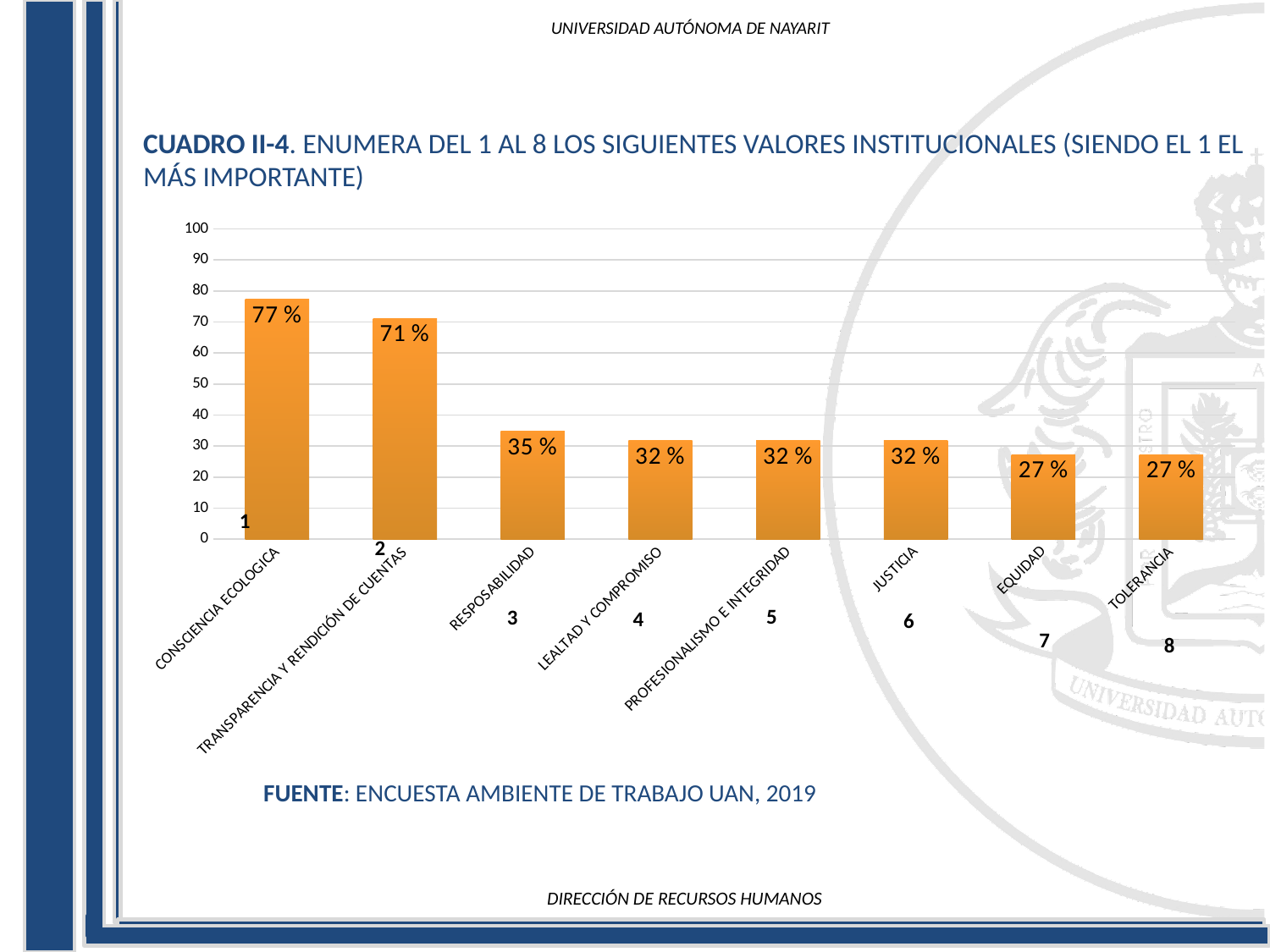
What is the difference between the values for CONSCIENCIA ECOLOGICA and TRANSPARENCIA Y RENDICIÓN DE CUENTAS? 6 % What is the value shown for CONSCIENCIA ECOLOGICA? 77 % What is the value shown for TOLERANCIA? 27 % What type of chart is shown on the slide? Bar chart Which category has the highest value in the chart? CONSCIENCIA ECOLOGICA What is the value shown for TRANSPARENCIA Y RENDICIÓN DE CUENTAS? 71 % According to the FUENTE line, what is the source of the chart data? ENCUESTA AMBIENTE DE TRABAJO UAN, 2019 What is the value shown for RESPOSABILIDAD? 35 % What is the value shown for JUSTICIA? 32 % How many institutional values (categories) are plotted in the chart? 8 Which is larger, the value for TRANSPARENCIA Y RENDICIÓN DE CUENTAS or the value for LEALTAD Y COMPROMISO? TRANSPARENCIA Y RENDICIÓN DE CUENTAS Do the values rise or fall moving from left to right along the x axis? Fall